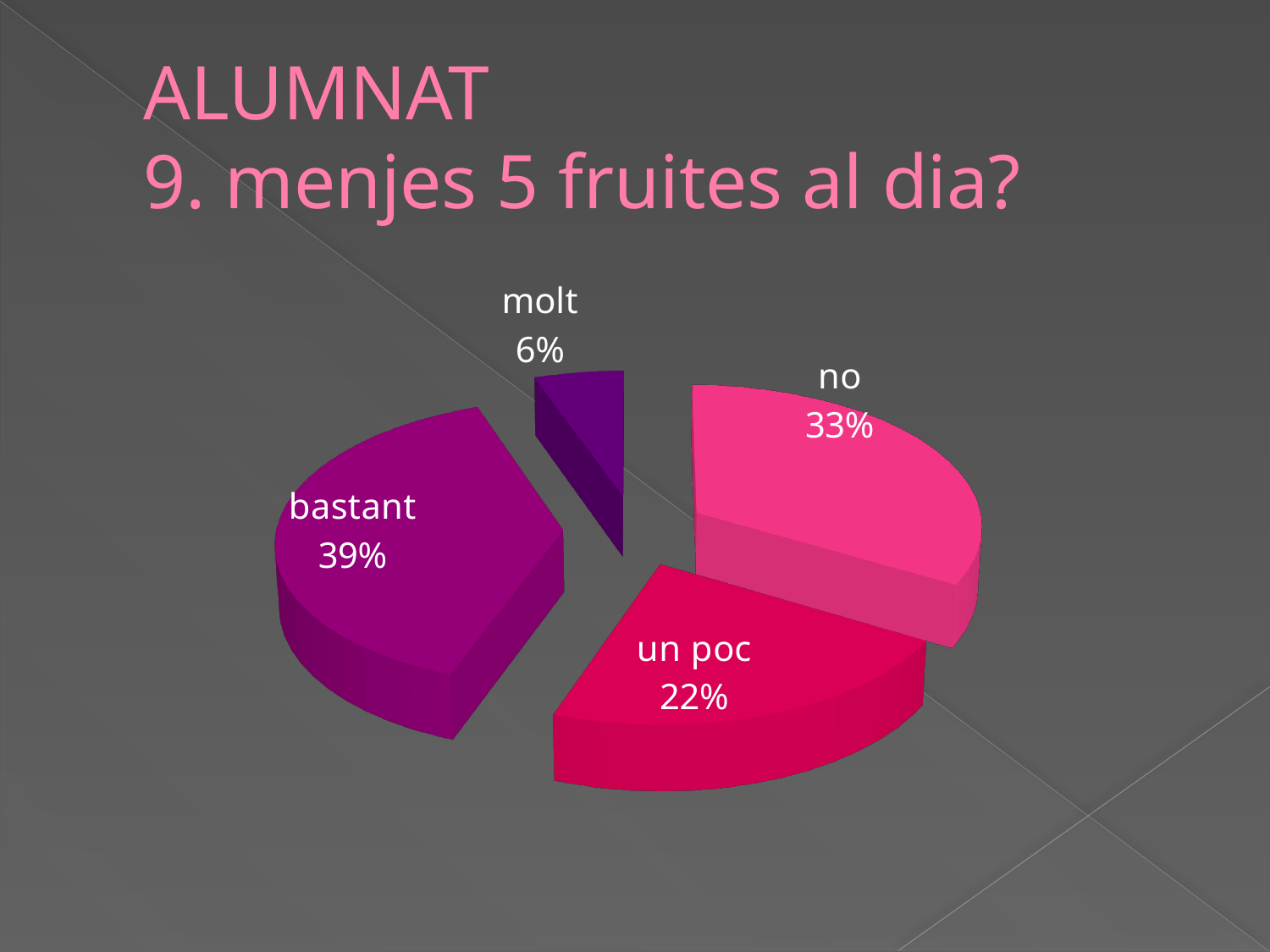
Which category has the smallest share of the pie? molt How many slices does the pie chart have? 4 Which is larger, the share for "un poc" or the share for "molt"? un poc Which category has the largest share of the pie? bastant What percentage of the pie is labelled "no"? 33% What is the difference in percentage points between "bastant" and "no"? 6 What is the difference in percentage points between "no" and "un poc"? 11 What percentage of the pie is labelled "un poc"? 22% What question does the slide title say the chart is about? 9. menjes 5 fruites al dia? What percentage of the pie is labelled "bastant"? 39% What percentage of the pie is labelled "molt"? 6% What kind of chart is shown on the slide? pie chart